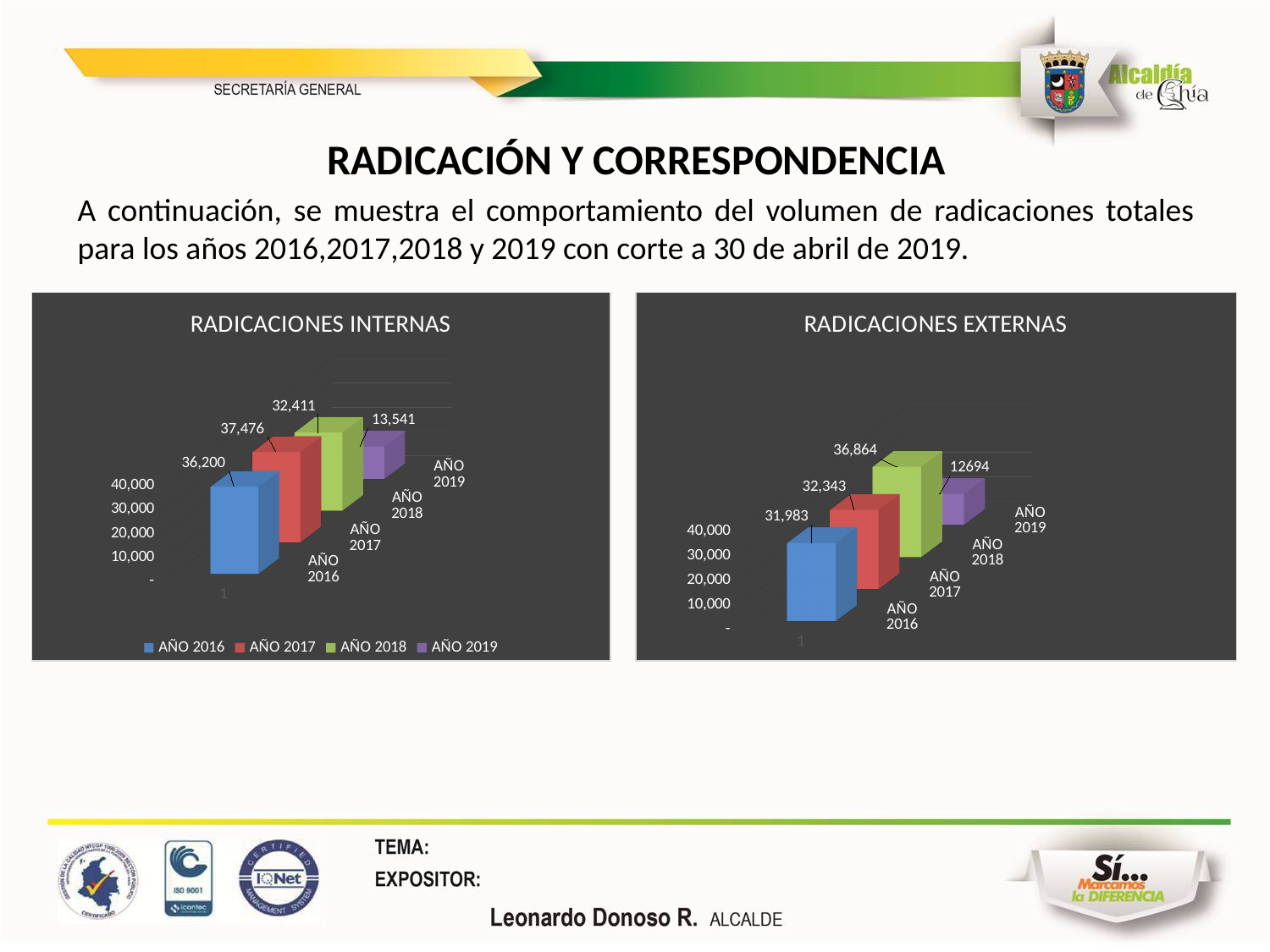
In the RADICACIONES EXTERNAS chart, which is larger, the value for AÑO 2018 or the value for AÑO 2016? AÑO 2018 In the RADICACIONES EXTERNAS chart, what is the value for AÑO 2016? 31,983 In the RADICACIONES INTERNAS chart, which year has the highest value? AÑO 2017 In the RADICACIONES EXTERNAS chart, which year has the lowest value? AÑO 2019 How many series does the legend of the RADICACIONES INTERNAS chart list? 4 How many years are plotted in the RADICACIONES INTERNAS chart? 4 In the RADICACIONES INTERNAS chart, what is the difference between the values for AÑO 2017 and AÑO 2016? 1,276 What kind of chart is the RADICACIONES EXTERNAS chart? Bar chart In the RADICACIONES EXTERNAS chart, what is the value for AÑO 2018? 36,864 In the RADICACIONES INTERNAS chart, what is the value for AÑO 2017? 37,476 In the RADICACIONES EXTERNAS chart, what is the difference between the values for AÑO 2018 and AÑO 2017? 4,521 In the RADICACIONES INTERNAS chart, what is the value for AÑO 2019? 13,541